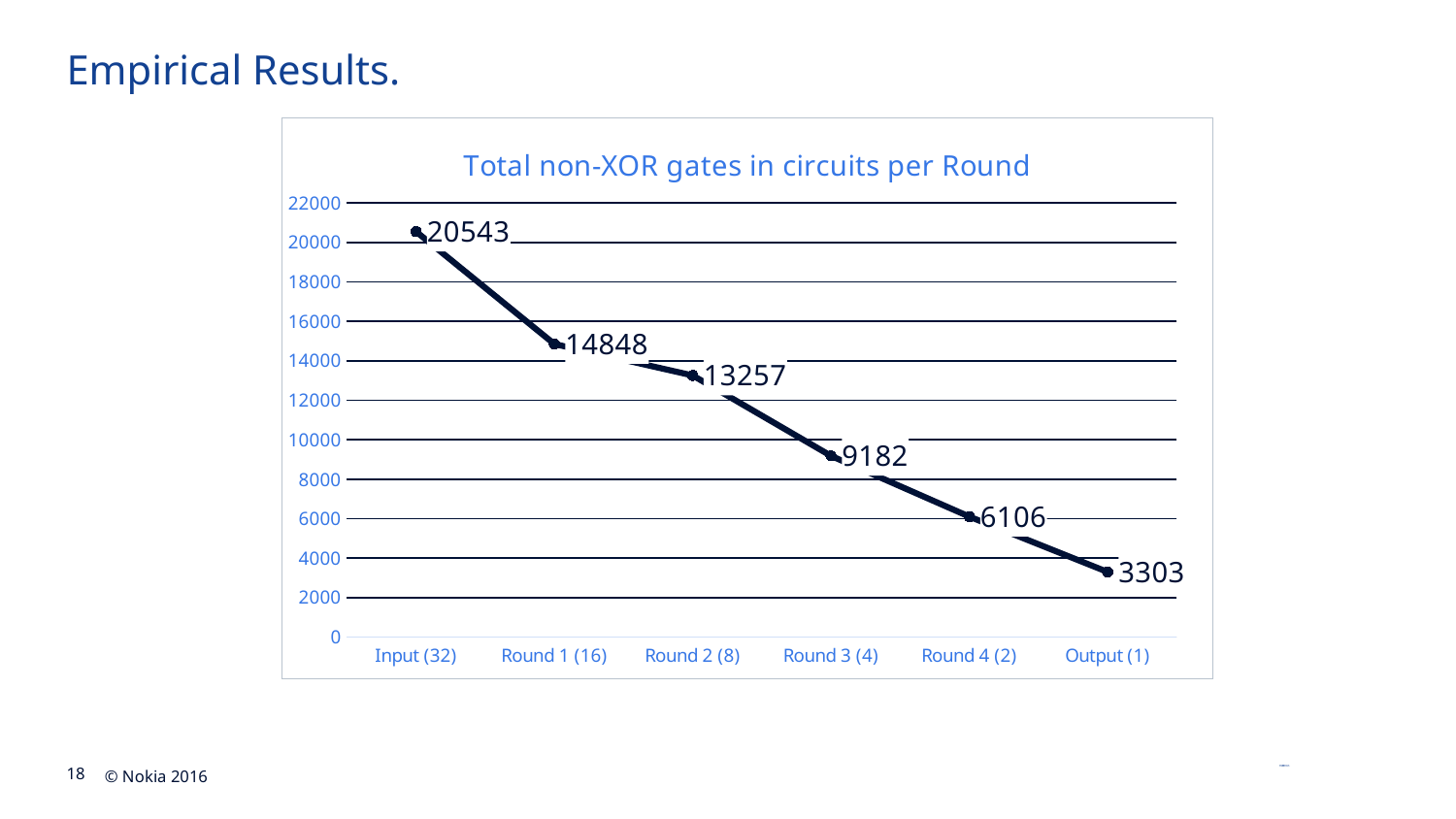
Is the value for Round 3 (4) greater or less than 10000? less What is the difference between the values for Round 3 (4) and Round 4 (2)? 3076 Do the values rise or fall from Input (32) to Output (1)? fall What is the value for Output (1)? 3303 Which is larger, the value for Round 1 (16) or the value for Round 2 (8)? Round 1 (16) Which category has the lowest value? Output (1) What is the value for Round 2 (8)? 13257 What is the difference between the values for Input (32) and Round 1 (16)? 5695 What kind of chart is shown? line chart What is the value for Input (32)? 20543 How many categories are plotted on the x axis? 6 Which category has the highest value? Input (32)